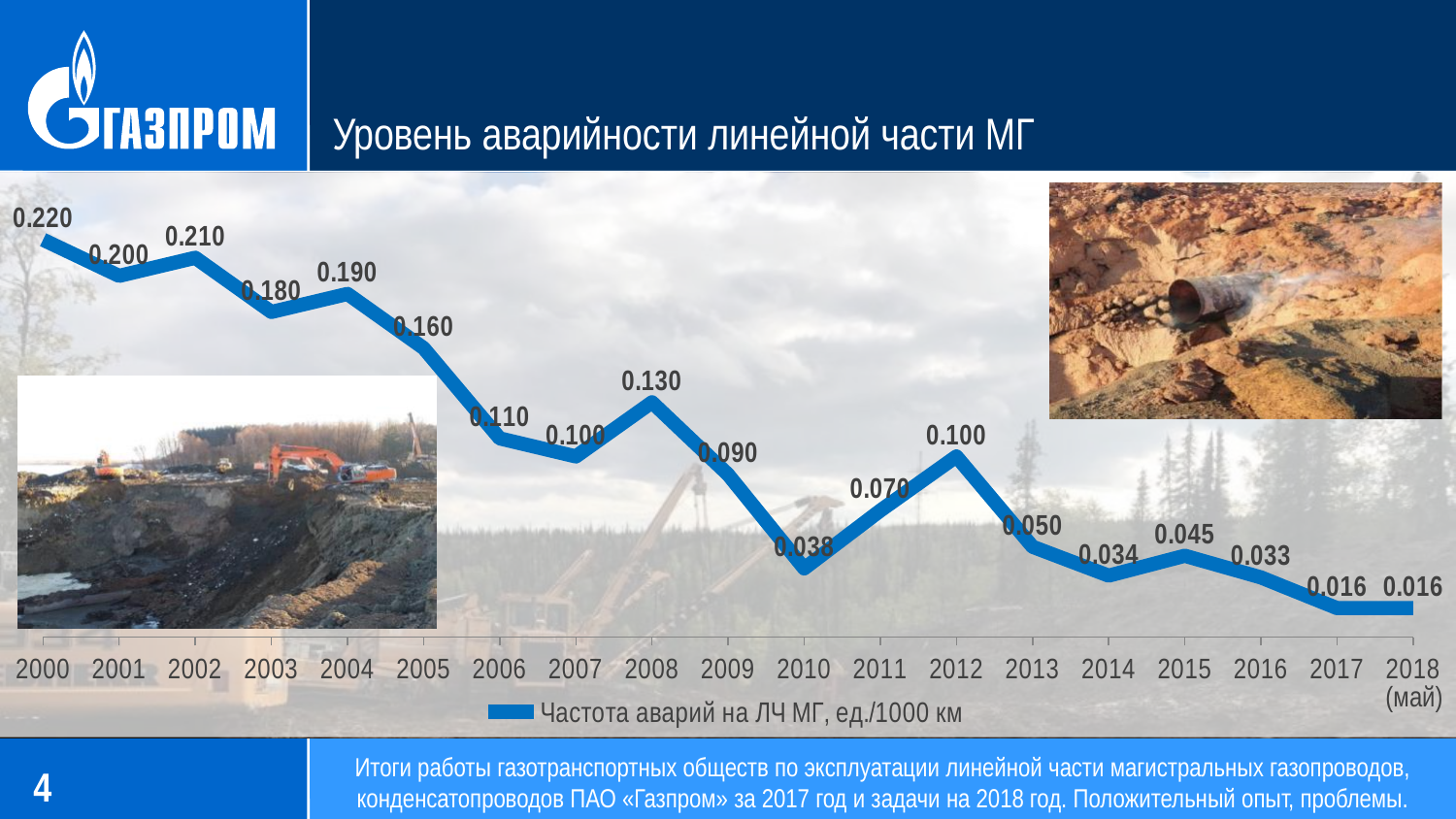
What is the difference between the values for 2000 and 2018 (май)? 0.204 What is the difference between the values for 2008 and 2009? 0.040 Which year has the highest accident frequency? 2000 What is the value for 2010? 0.038 What type of chart is shown on the slide? line chart How many series does the legend list? 1 Does the accident frequency generally rise or fall from 2000 to 2018? fall How many data points are plotted on the chart? 19 What is the value of the accident frequency (Частота аварий на ЛЧ МГ) for 2000? 0.220 What is the value for 2012? 0.100 What is the value for 2018 (май)? 0.016 Which is larger, the value for 2011 or the value for 2013? 2011